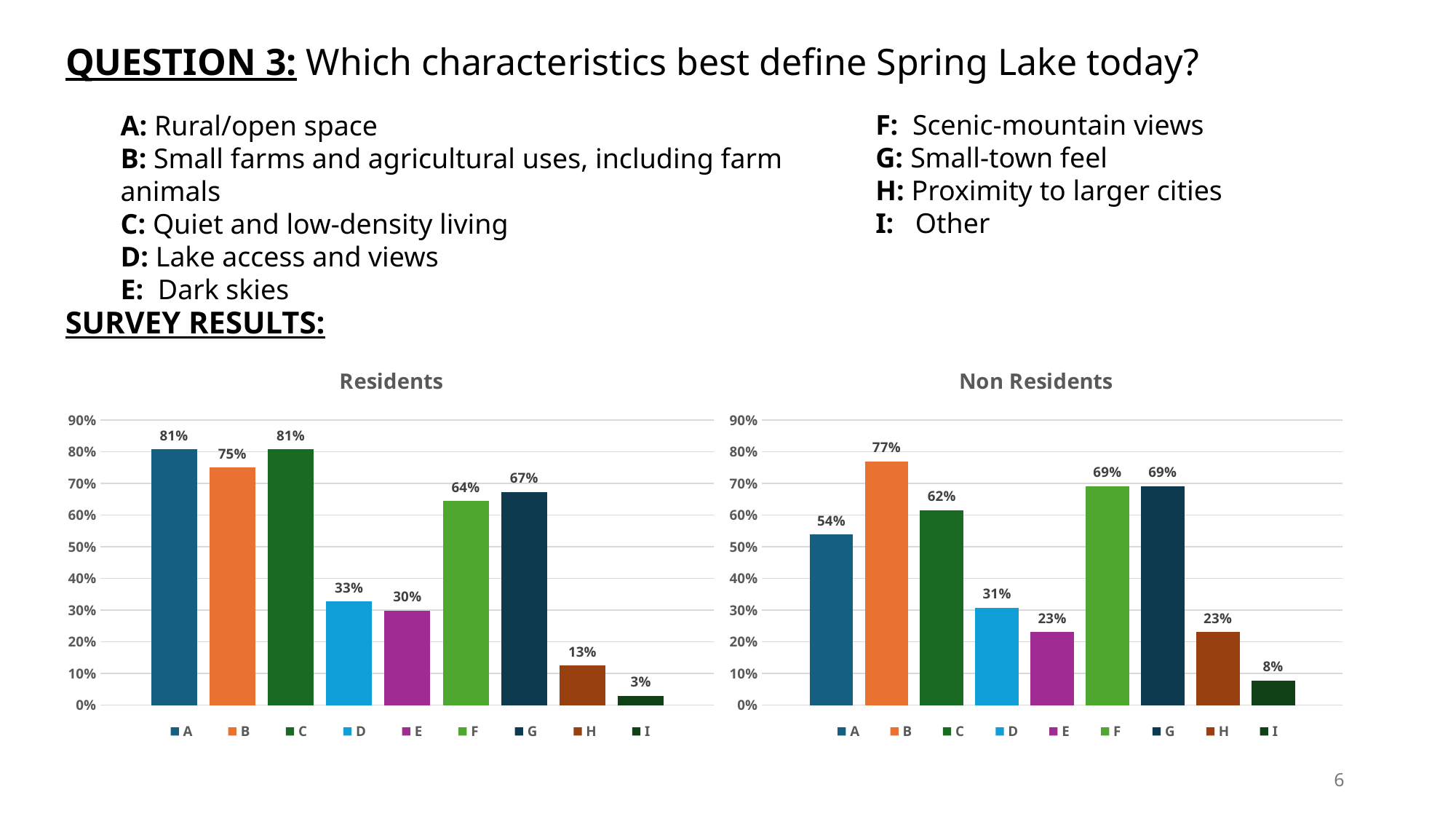
In the Non Residents chart, which category has the lowest value? I In the Non Residents chart, what is the value for category A? 54% In the Residents chart, which category has the lowest value? I In the Non Residents chart, which category has the highest value? B In the Residents chart, what is the difference between the values for G and F? 3% In the Non Residents chart, what is the difference between the values for B and C? 15% How many entries does the legend of the Non Residents chart list? 9 In the Residents chart, what is the value for category B? 75% In the Non Residents chart, how many categories are shown? 9 In the Residents chart, which is larger, the value for D or the value for E? D What type of chart is the Residents chart? Bar chart In the Residents chart, what is the value for category H? 13%